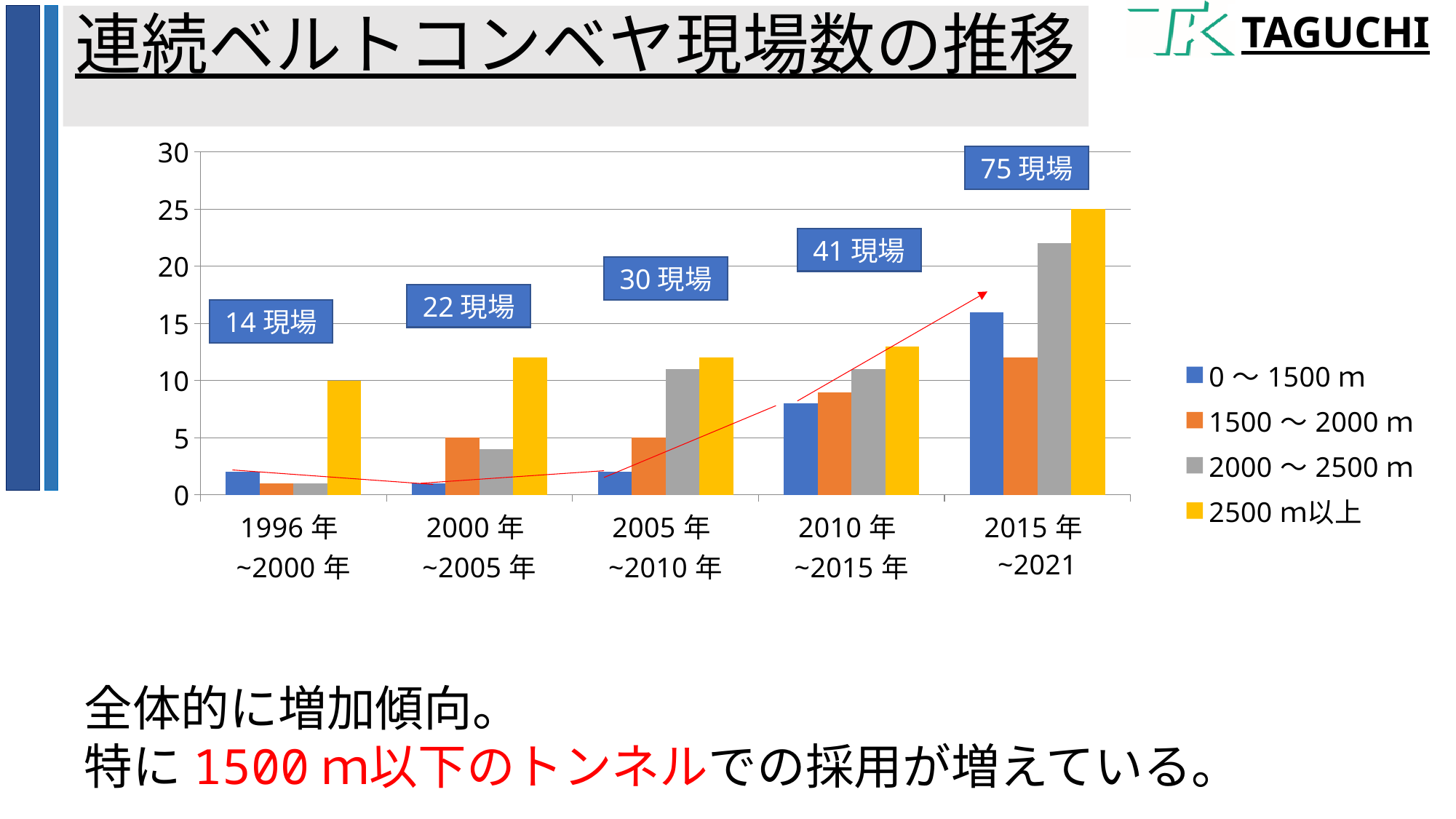
What total number of sites is labelled for the 1996年~2000年 period? 14 現場 In the 2015年~2021 period, which is larger: 2500 m以上 or 0 ～ 1500 m? 2500 m以上 Do the labelled totals rise or fall from 1996年~2000年 to 2015年~2021? rise What total number of sites is labelled for the 2015年~2021 period? 75 現場 How many time periods are shown on the x axis? 5 What is the title of the chart on the slide? 連続ベルトコンベヤ現場数の推移 What kind of chart is shown on the slide? bar chart Is the value for 2000 ～ 2500 m in the 2015年~2021 period greater or less than 20? greater What is the difference between the labelled totals for 2015年~2021 and 2010年~2015年? 34 Which period has the lowest labelled total of sites? 1996年~2000年 Which period has the highest labelled total of sites? 2015年~2021 How many series does the legend list? 4